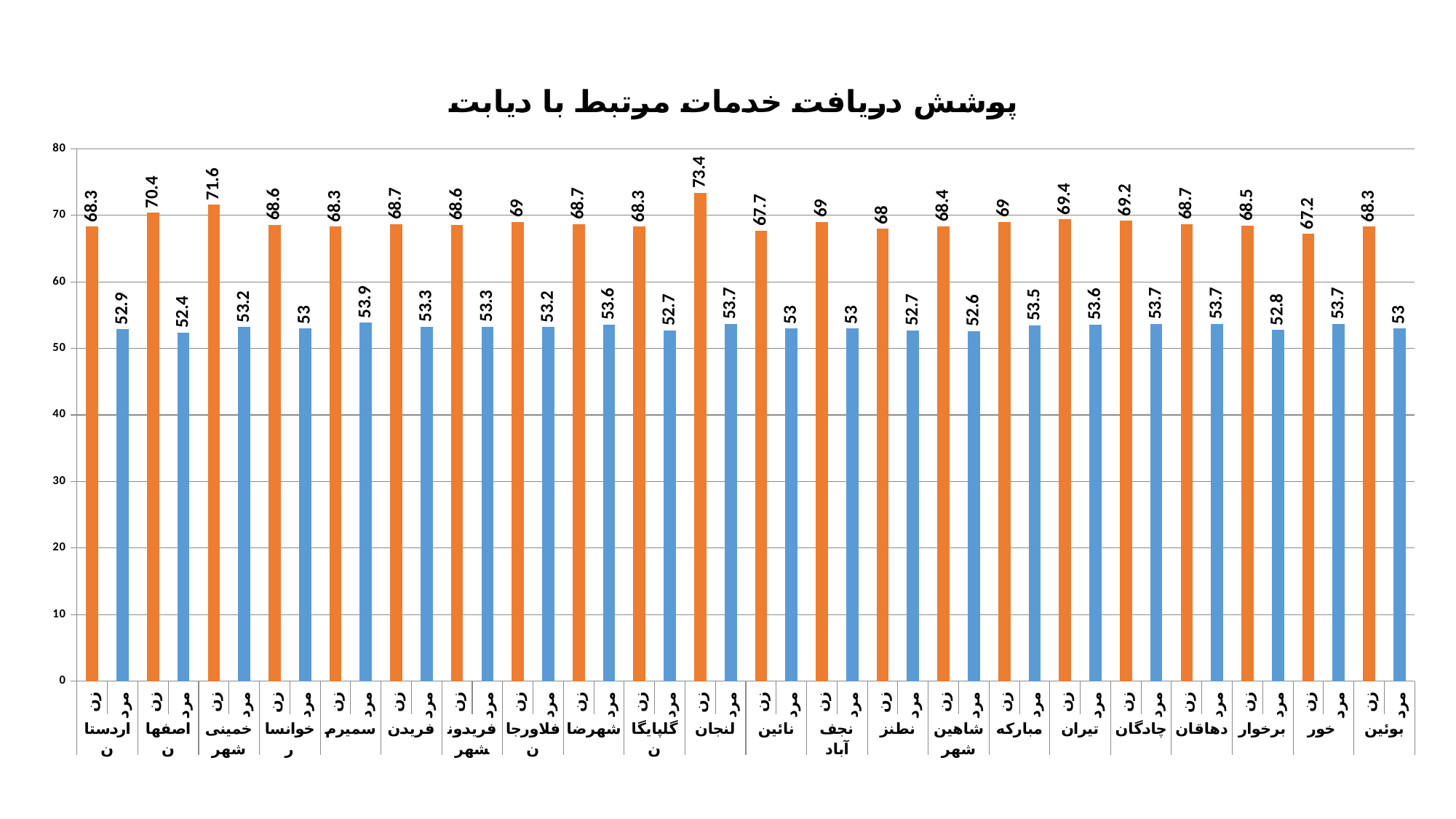
What type of chart is shown on the slide? bar chart What is the difference between the زن and مرد values for لنجان? 19.7 What is the value of the زن bar for لنجان? 73.4 What is the value of the مرد bar for اصفهان? 52.4 Which city has the lowest مرد value? اصفهان Which city has the highest مرد value? سمیرم Which city has the highest زن value? لنجان Which city has the lowest زن value? خور How many cities are shown on the x axis? 22 What is the value of the زن bar for خمینی شهر? 71.6 What is the title of the chart? پوشش دریافت خدمات مرتبط با دیابت Which is larger for اردستان, the زن value or the مرد value? زن